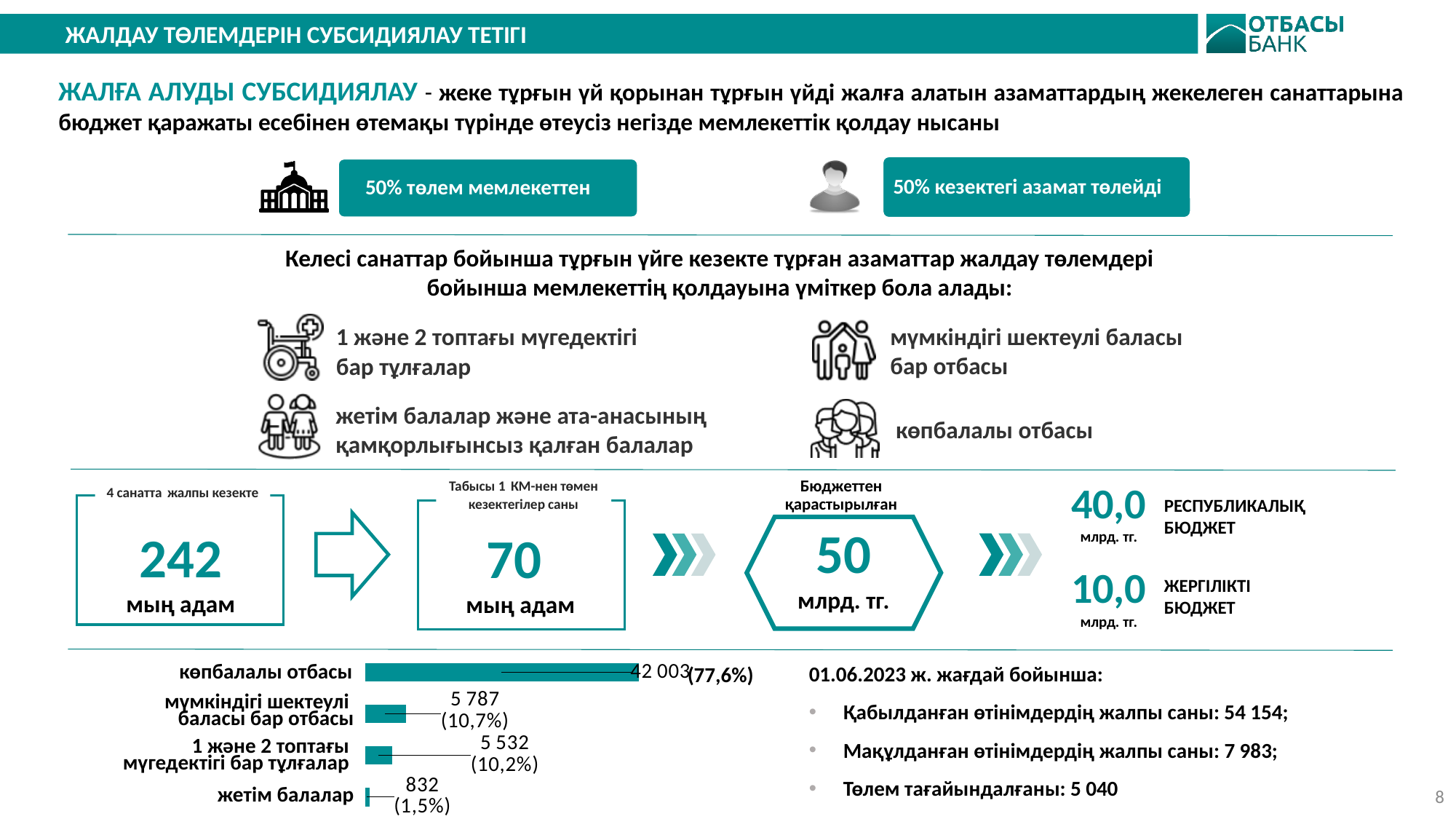
What type of chart is shown at the bottom left of the slide? bar chart In the bar chart, which is larger: the value for мүмкіндігі шектеулі баласы бар отбасы or the value for 1 және 2 топтағы мүгедектігі бар тұлғалар? мүмкіндігі шектеулі баласы бар отбасы In the bar chart, what percentage is shown for жетім балалар? 1,5% How many categories does the bar chart at the bottom left of the slide show? 4 In the bar chart, what is the value for 1 және 2 топтағы мүгедектігі бар тұлғалар? 5 532 In the bar chart, what is the difference between the values for көпбалалы отбасы and мүмкіндігі шектеулі баласы бар отбасы? 36 216 In the bar chart, what percentage is shown for көпбалалы отбасы? 77,6% In the bar chart, what is the value for жетім балалар? 832 In the bar chart, what is the value for көпбалалы отбасы? 42 003 Which category has the highest value in the bar chart? көпбалалы отбасы In the bar chart, what is the value for мүмкіндігі шектеулі баласы бар отбасы? 5 787 Which category has the lowest value in the bar chart? жетім балалар